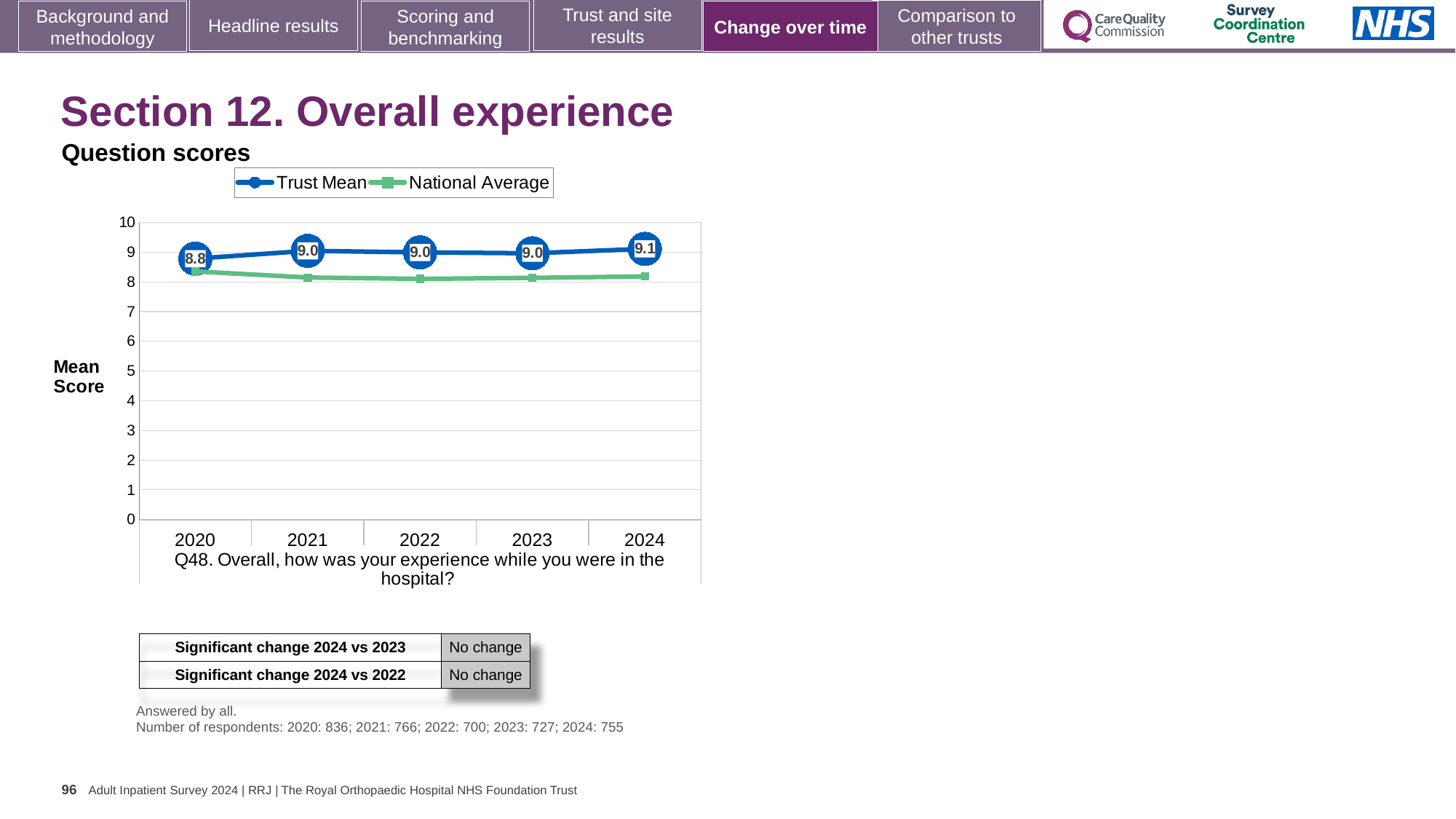
What is the Trust Mean value for 2024? 9.1 What is the difference between the Trust Mean in 2024 and in 2020? 0.3 In which year is the Trust Mean lowest? 2020 In 2022, which series has the higher value, Trust Mean or National Average? Trust Mean Does the Trust Mean rise or fall from 2020 to 2024? Rise What kind of chart is shown on the slide? Line chart What is the Trust Mean value for 2022? 9.0 How many years are plotted on the x axis? 5 How many series does the legend list? 2 In which year is the Trust Mean highest? 2024 What is the Trust Mean value for 2020? 8.8 Is the National Average value for 2021 greater or less than 9? less